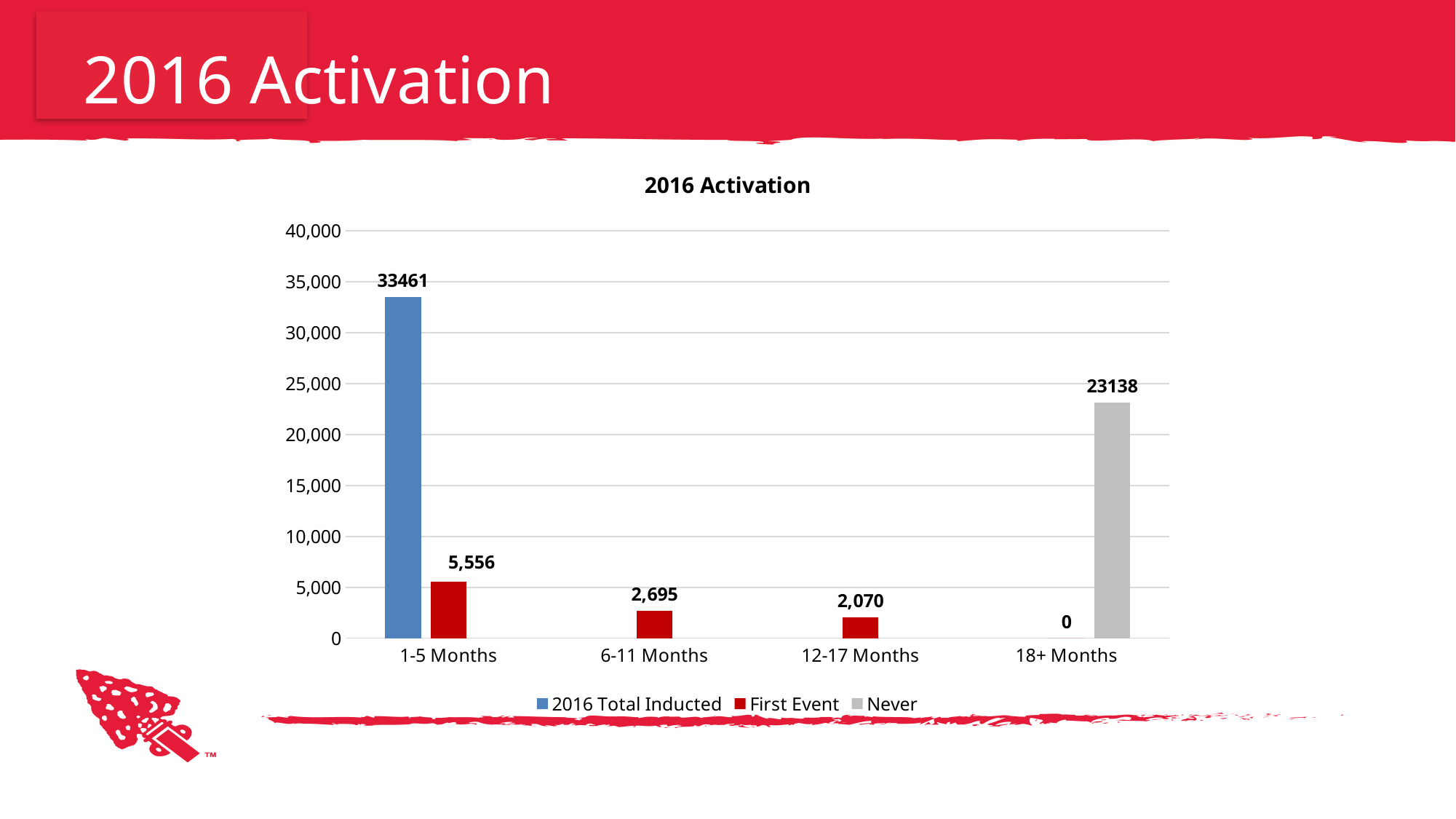
Which category has the lowest First Event value? 18+ Months How many categories are shown on the x axis? 4 Which category has the highest First Event value? 1-5 Months What is the First Event value for 6-11 Months? 2,695 What is the First Event value for 18+ Months? 0 What is the value of 2016 Total Inducted for 1-5 Months? 33461 What is the difference between the First Event values for 1-5 Months and 6-11 Months? 2,861 How many series does the legend list? 3 What kind of chart is shown on the slide? Bar chart What is the Never value for 18+ Months? 23138 What is the First Event value for 12-17 Months? 2,070 Which is larger: the 2016 Total Inducted value for 1-5 Months or the Never value for 18+ Months? 2016 Total Inducted for 1-5 Months